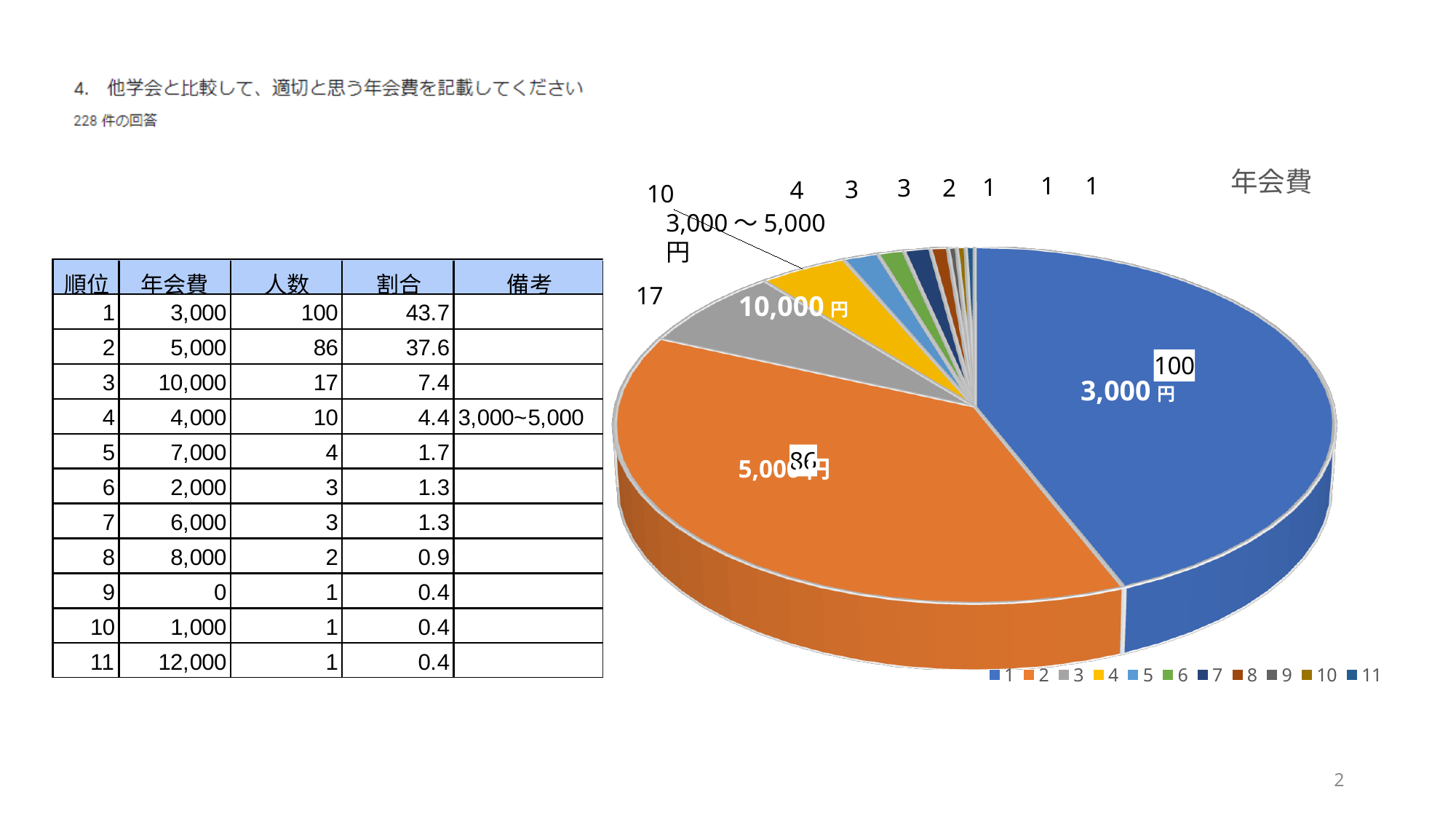
Which slice of the pie chart is the largest? 3,000円 What colour is the largest slice of the pie chart? blue What is the data label value for the 5,000円 slice of the pie chart? 86 What type of chart is shown on the slide? pie chart What is the difference between the 10,000円 slice value and the 3,000～5,000円 slice value? 7 What is the data label value for the 3,000～5,000円 slice of the pie chart? 10 Which is larger in the pie chart, the 5,000円 slice or the 10,000円 slice? 5,000円 What is the data label value for the 3,000円 slice of the pie chart? 100 What is the data label value for the 10,000円 slice of the pie chart? 17 What is the title of the chart? 年会費 How many series does the chart legend list? 11 What is the difference between the 3,000円 slice value and the 5,000円 slice value? 14